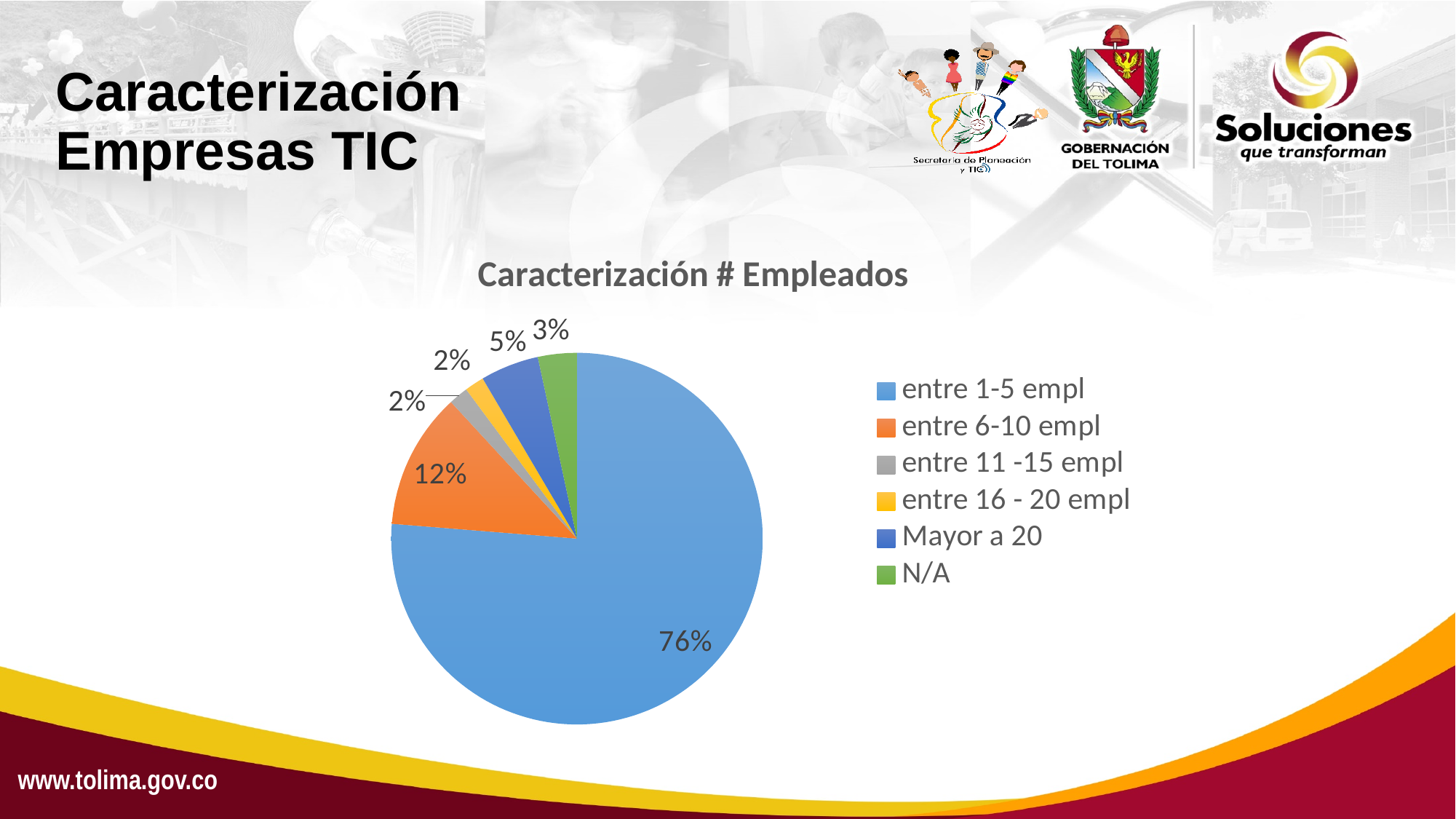
What share of the pie does 'entre 16 - 20 empl' represent? 2% What colour is the slice for 'entre 6-10 empl'? orange Which is larger, the slice for 'Mayor a 20' or the slice for 'N/A'? Mayor a 20 How many categories does the legend list? 6 What is the title of the chart? Caracterización # Empleados What share of the pie does 'entre 6-10 empl' represent? 12% What type of chart is shown on the slide? pie chart What share of the pie does 'entre 1-5 empl' represent? 76% Which category has the largest slice of the pie? entre 1-5 empl What is the difference in percentage points between 'entre 1-5 empl' and 'entre 6-10 empl'? 64